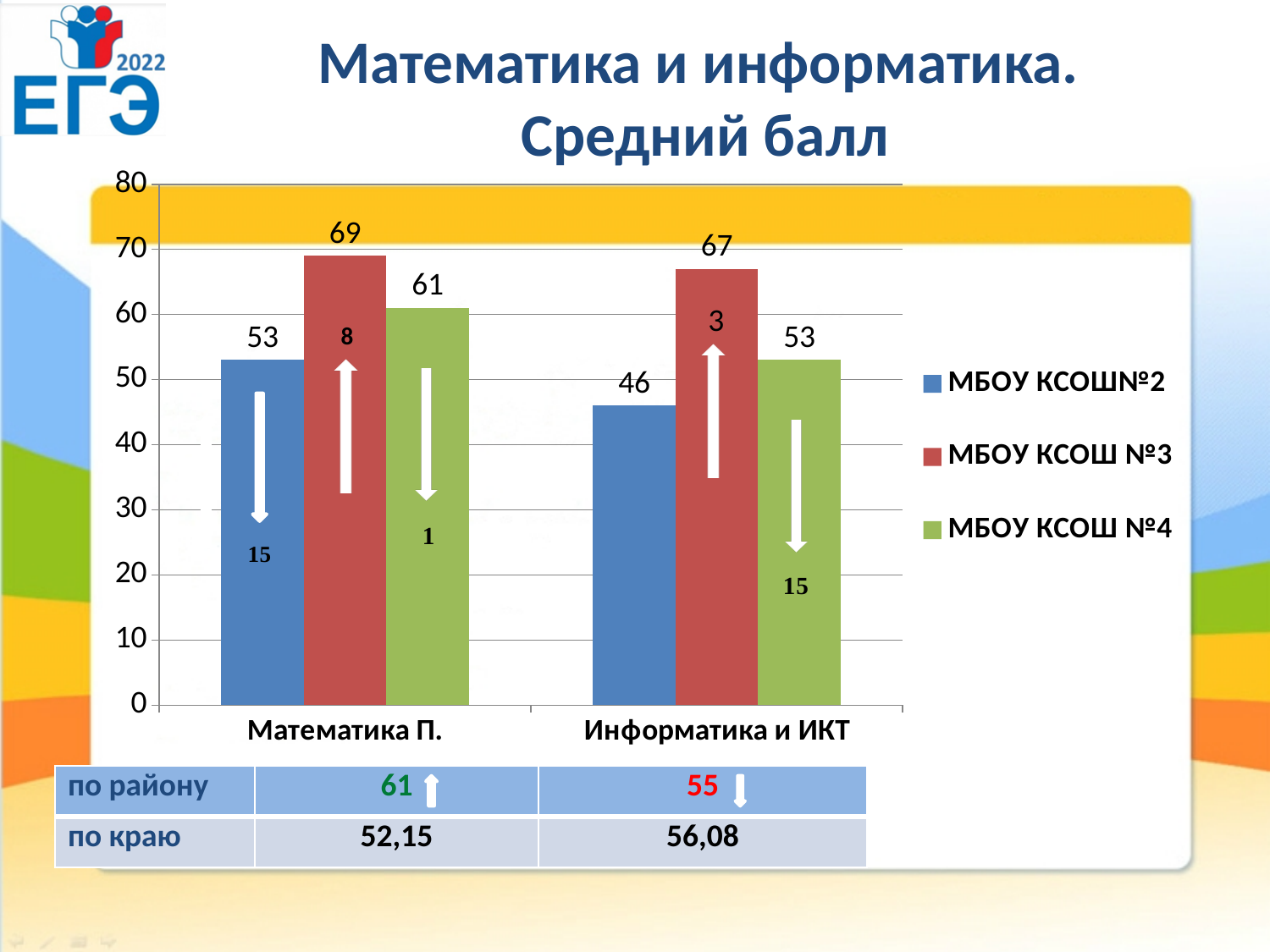
Which school has the lowest average score in Информатика и ИКТ? МБОУ КСОШ№2 What is the difference between the Информатика и ИКТ scores of МБОУ КСОШ №3 and МБОУ КСОШ №4? 14 How many series does the legend list? 3 How many subject categories are shown on the x axis? 2 What is the difference between the Математика П. scores of МБОУ КСОШ №3 and МБОУ КСОШ№2? 16 What is the average score for МБОУ КСОШ №4 in Информатика и ИКТ? 53 Which school has the highest average score in Математика П.? МБОУ КСОШ №3 What is the average score for МБОУ КСОШ №3 in Математика П.? 69 What kind of chart is shown on the slide? Bar chart What is the average score for МБОУ КСОШ№2 in Информатика и ИКТ? 46 What colour represents МБОУ КСОШ №4 in the chart? Green Which is larger: the Математика П. score of МБОУ КСОШ №4 or the Информатика и ИКТ score of МБОУ КСОШ №4? Математика П.